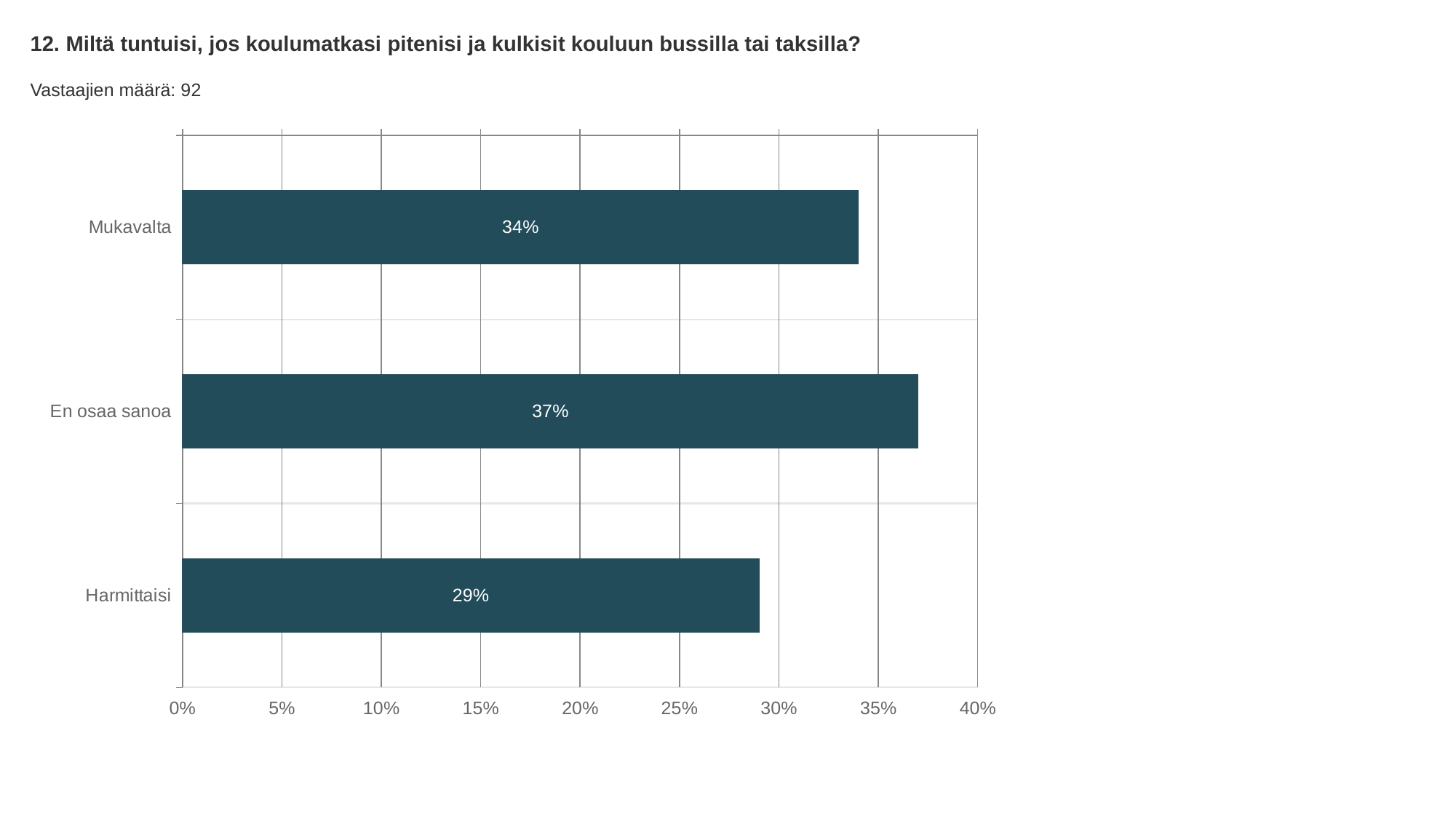
What is the value for Mukavalta? 34% What is the value for Harmittaisi? 29% How many respondents (Vastaajien määrä) are reported on the slide? 92 What is the value for En osaa sanoa? 37% What is the difference between the values for En osaa sanoa and Harmittaisi? 8% Which is larger, the value for Mukavalta or the value for En osaa sanoa? En osaa sanoa Which category has the lowest value? Harmittaisi How many categories are shown in the chart? 3 What kind of chart is shown on the slide? bar chart What is the difference between the values for Mukavalta and Harmittaisi? 5% Is the value for Harmittaisi greater or less than 30%? less Which category has the highest value? En osaa sanoa